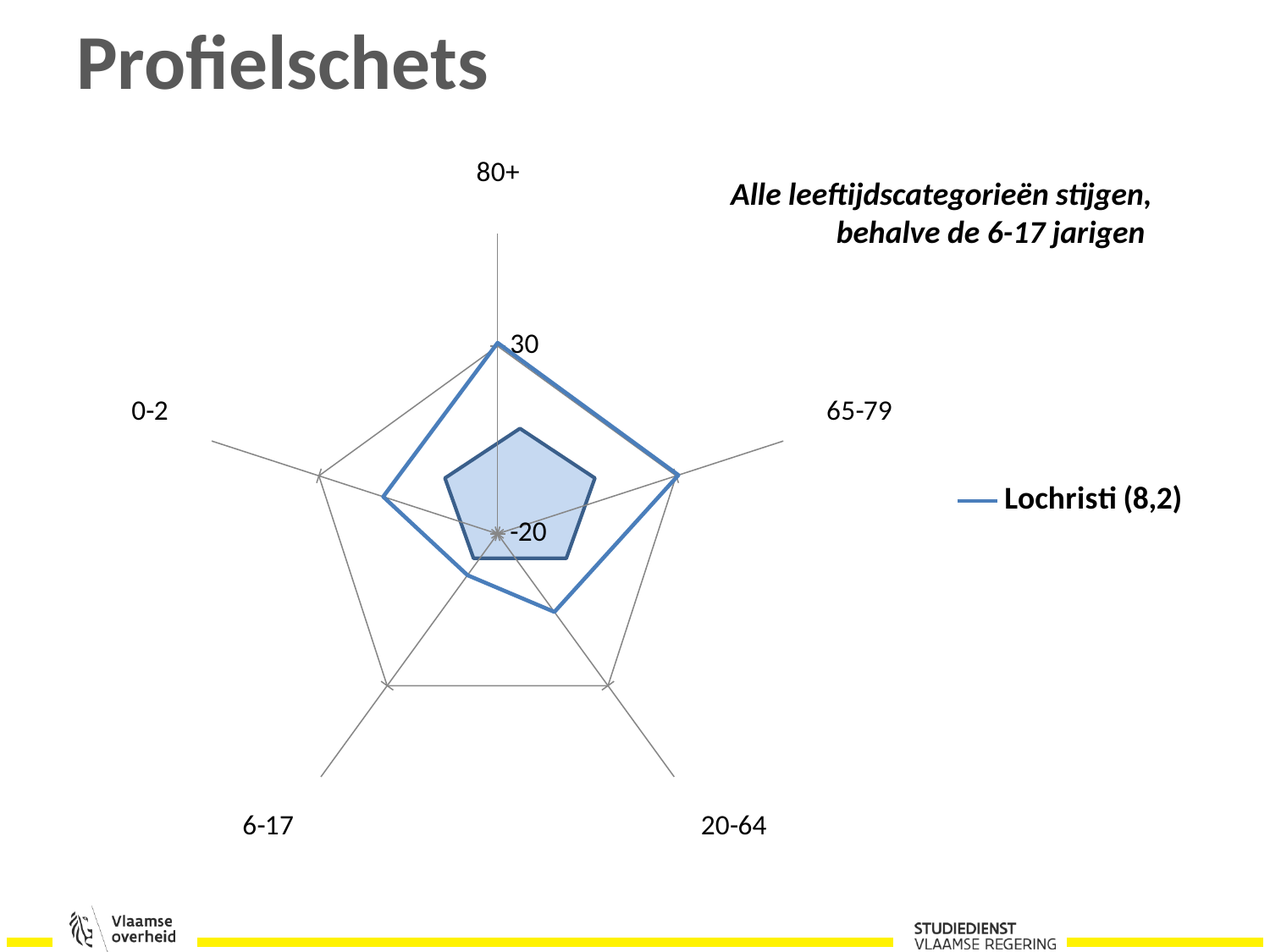
Is the Lochristi value for 20-64 greater or less than 30? less Is the Lochristi value for 6-17 greater or less than -20? greater Is the Lochristi value for 6-17 greater or less than 30? less What kind of chart is shown on the slide? radar chart Which age category has the lowest value on the Lochristi line? 6-17 Which has the larger Lochristi value, 80+ or 6-17? 80+ Which has the larger Lochristi value, 65-79 or 20-64? 65-79 How many series does the legend of the chart list? 1 What is the legend entry shown next to the chart? Lochristi (8,2) What is the highest axis tick value labelled on the radar chart? 30 How many age categories are plotted on the radar chart? 5